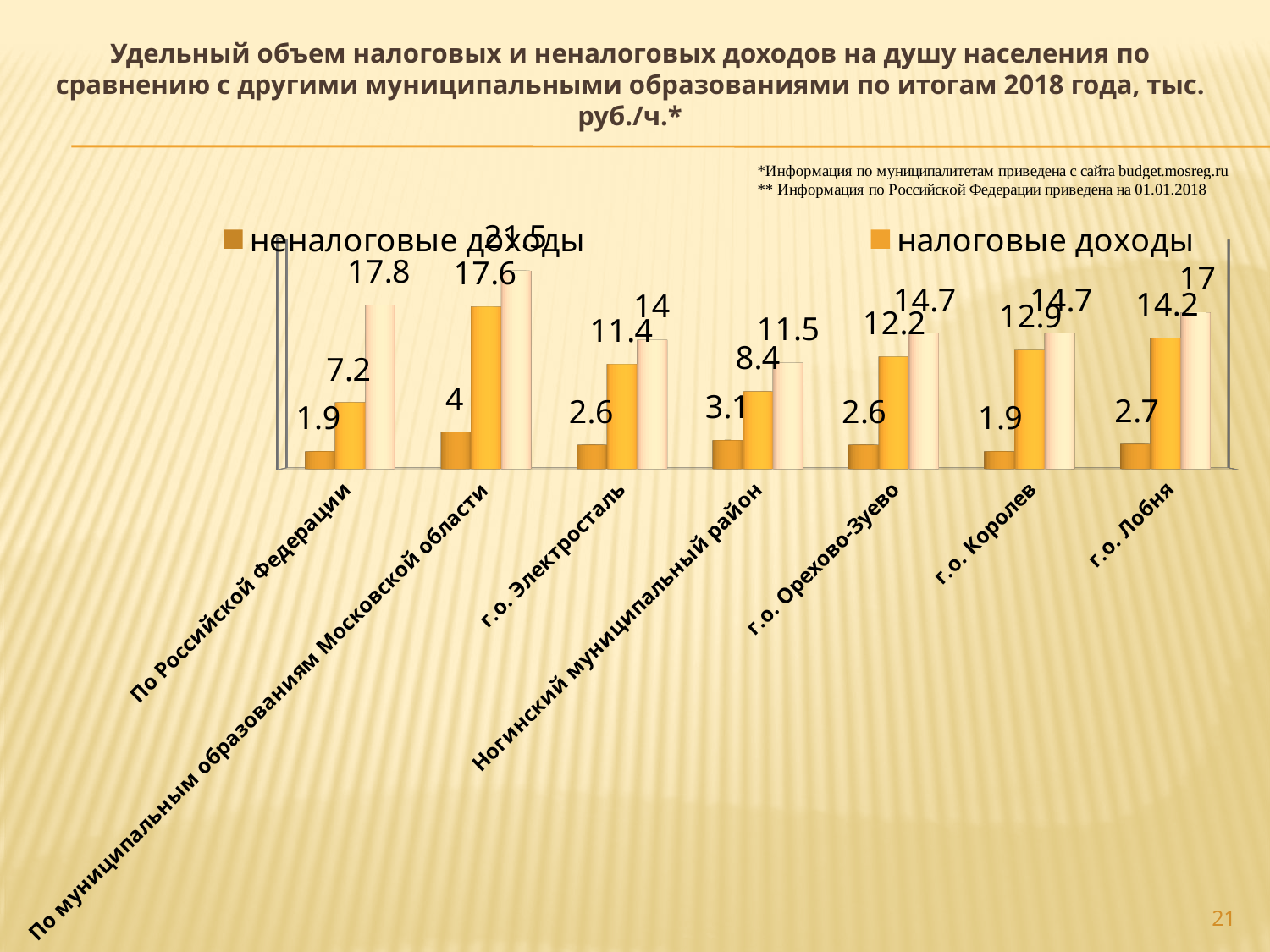
Which category has the highest value of налоговые доходы? По муниципальным образованиям Московской области What is the value of налоговые доходы for г.о. Лобня? 14.2 How many categories are shown on the x axis? 7 How many series does the legend list? 2 What is the value of неналоговые доходы for По муниципальным образованиям Московской области? 4 Which is larger: налоговые доходы for г.о. Лобня or for г.о. Королев? г.о. Лобня Which series is shown in the darker orange colour according to the legend? неналоговые доходы What is the difference between налоговые доходы for г.о. Королев and г.о. Орехово-Зуево? 0.7 What is the value of налоговые доходы for г.о. Электросталь? 11.4 What is the value of неналоговые доходы for Ногинский муниципальный район? 3.1 Which category has the lowest value of налоговые доходы? По Российской Федерации What kind of chart is shown on the slide? Bar chart